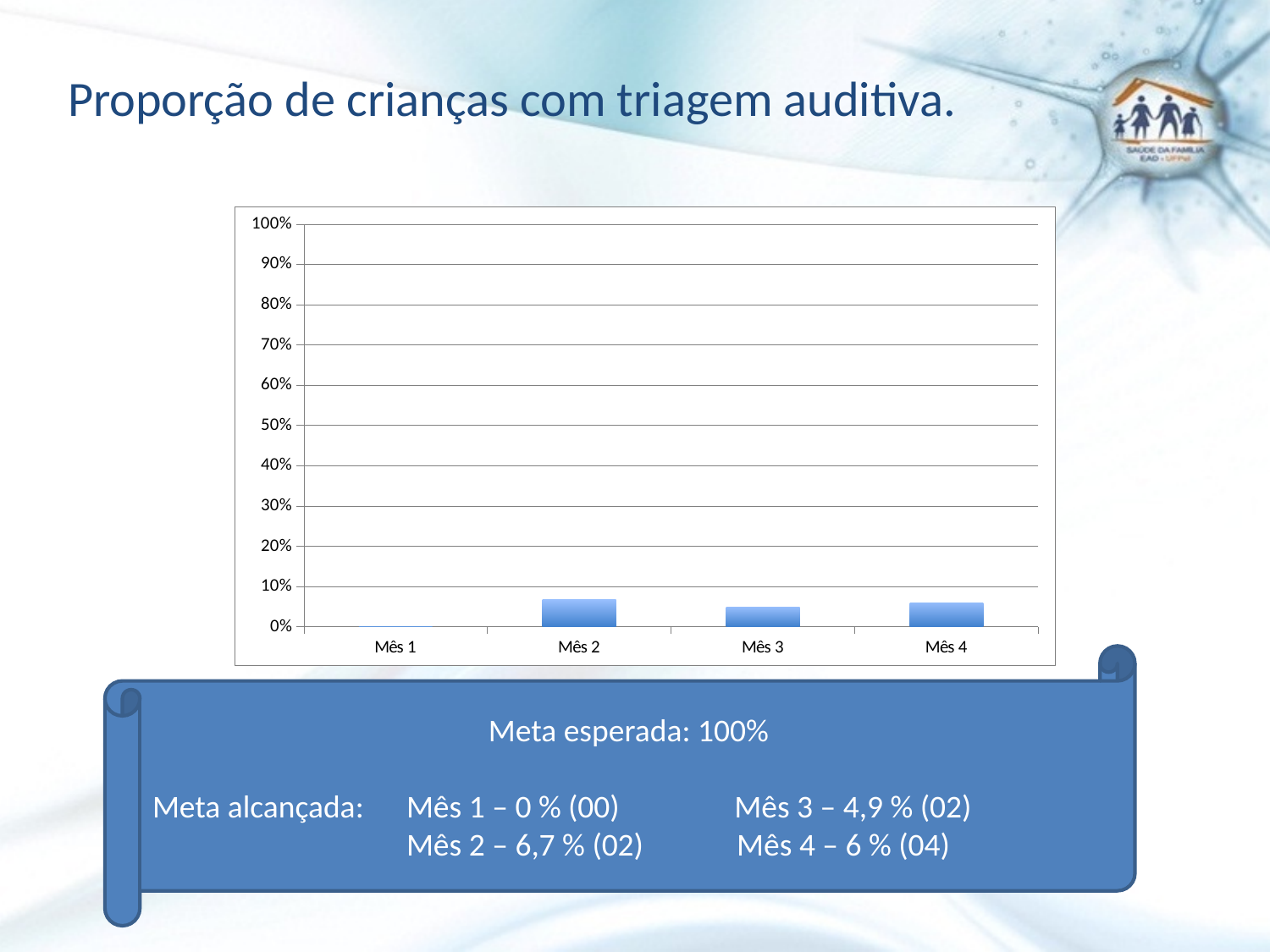
How many months (categories) are plotted on the chart? 4 According to the slide, what proportion was reached in Mês 1? 0 % What is the difference between the values for Mês 2 and Mês 3, using the figures printed on the slide? 1,8 % What is the expected target (meta esperada) stated on the slide? 100% According to the slide, what proportion was reached in Mês 3? 4,9 % According to the slide, what proportion was reached in Mês 4? 6 % According to the slide, what proportion was reached in Mês 2? 6,7 % Which month has the lowest value on the chart? Mês 1 What kind of chart is shown on the slide? bar chart Is the value for Mês 2 greater or less than 10%? less Which is larger, the value for Mês 2 or the value for Mês 3? Mês 2 What is the title of the slide containing the chart? Proporção de crianças com triagem auditiva.